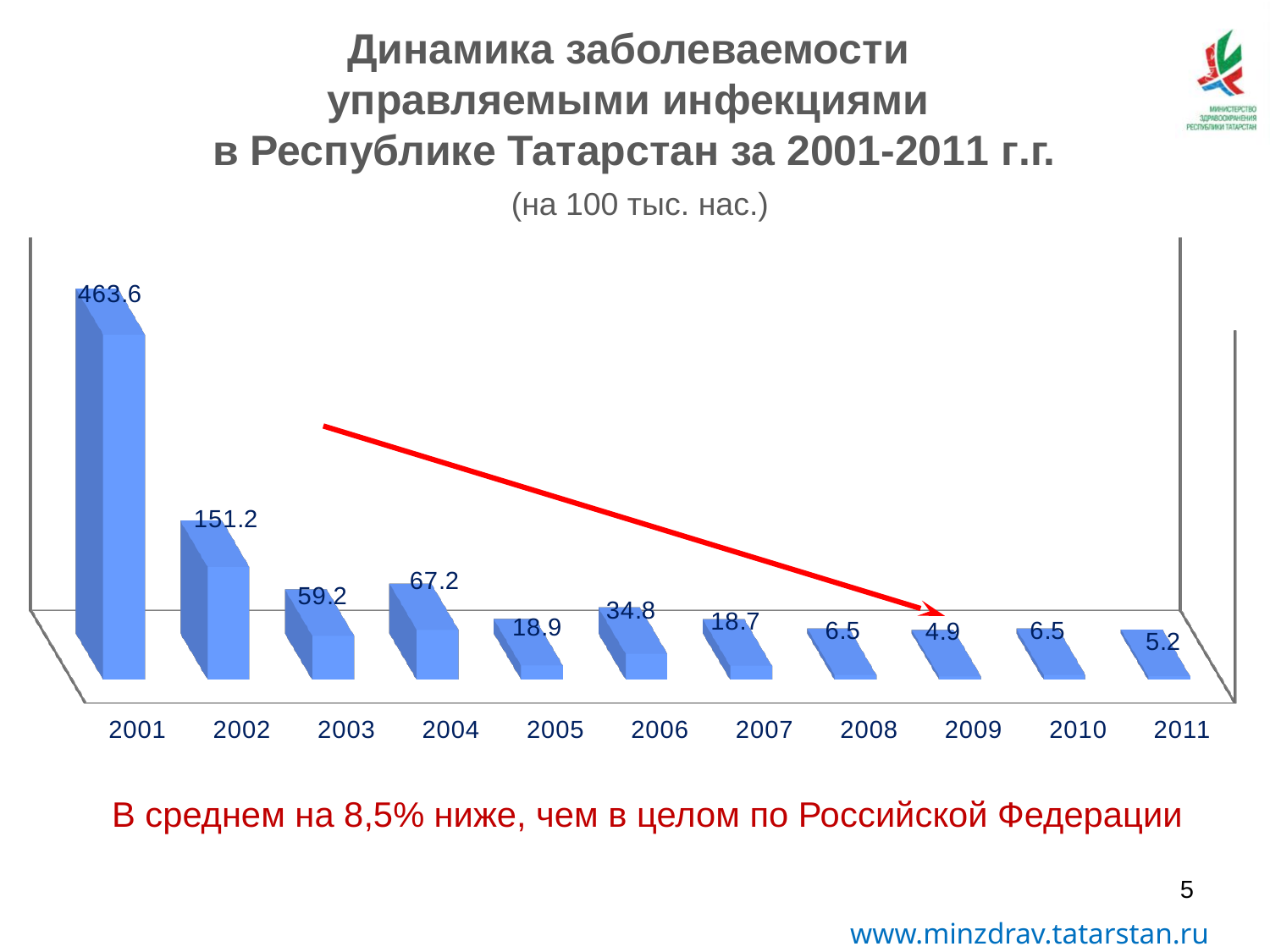
Which is larger, the value for 2005 or the value for 2006? 2006 Which year has the lowest value? 2009 What is the difference between the values for 2001 and 2002? 312.4 Do the values generally rise or fall from 2001 to 2011? fall How many years are shown on the x axis? 11 Which year has the highest value? 2001 What is the difference between the values for 2003 and 2004? 8 What is the value for 2004? 67.2 What is the value for 2011? 5.2 What is the value for 2009? 4.9 What is the value for 2001? 463.6 What kind of chart is this? bar chart